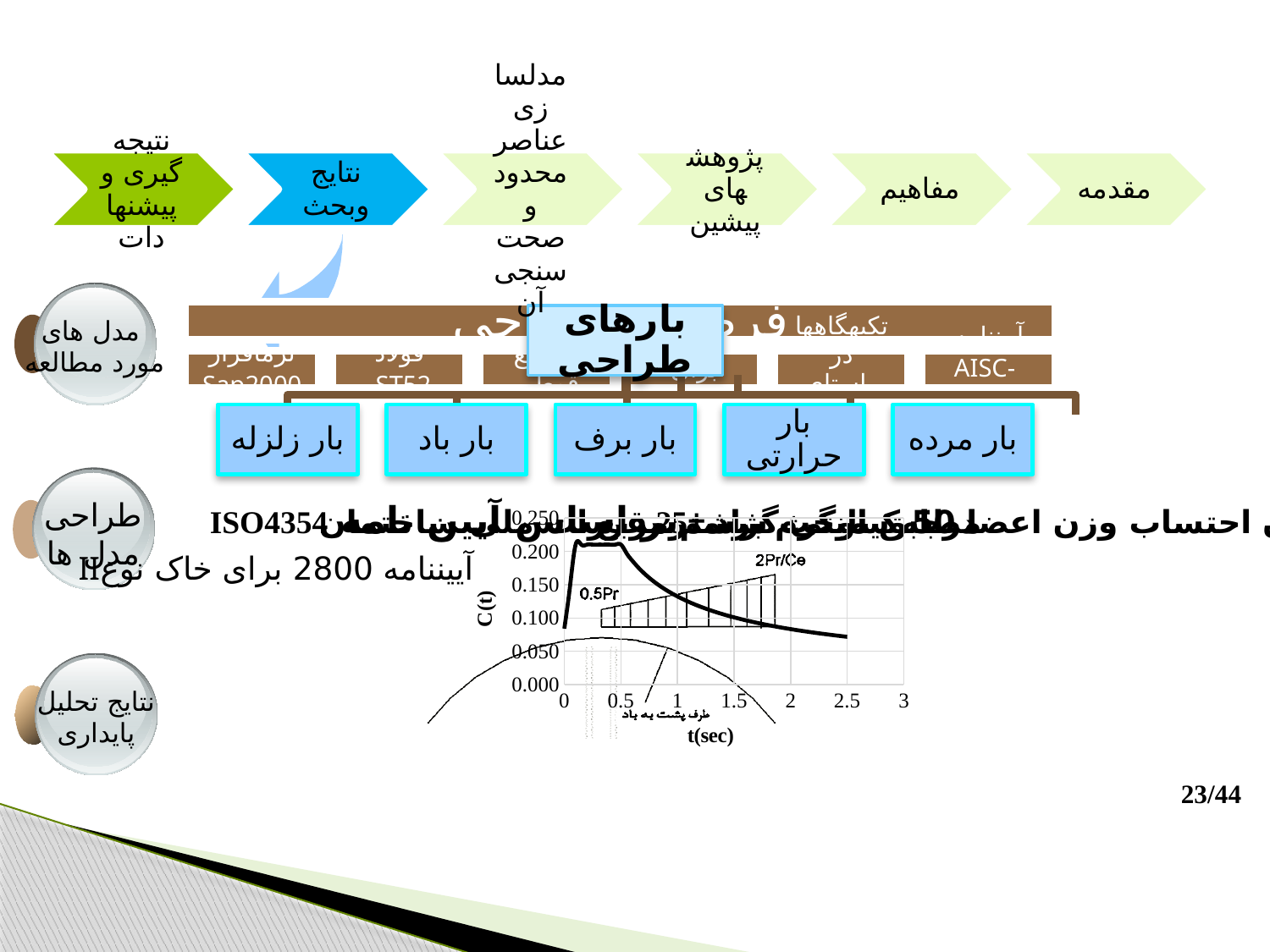
What kind of chart is shown at the bottom of the slide? line chart What is the label of the horizontal axis of the chart? t(sec) Which is larger, the value of C(t) at t = 0.5 sec or at t = 2.5 sec? t = 0.5 sec After the curve reaches its peak, do the values of C(t) rise or fall as t increases? fall What is the highest tick value shown on the vertical axis of the chart? 0.250 What is the highest tick value shown on the horizontal axis of the chart? 3 Is the value of C(t) at t = 0.5 sec greater or less than 0.150? greater Is the value of C(t) at t = 1.5 sec greater or less than 0.150? less Is the value of C(t) at t = 2.5 sec greater or less than 0.100? less